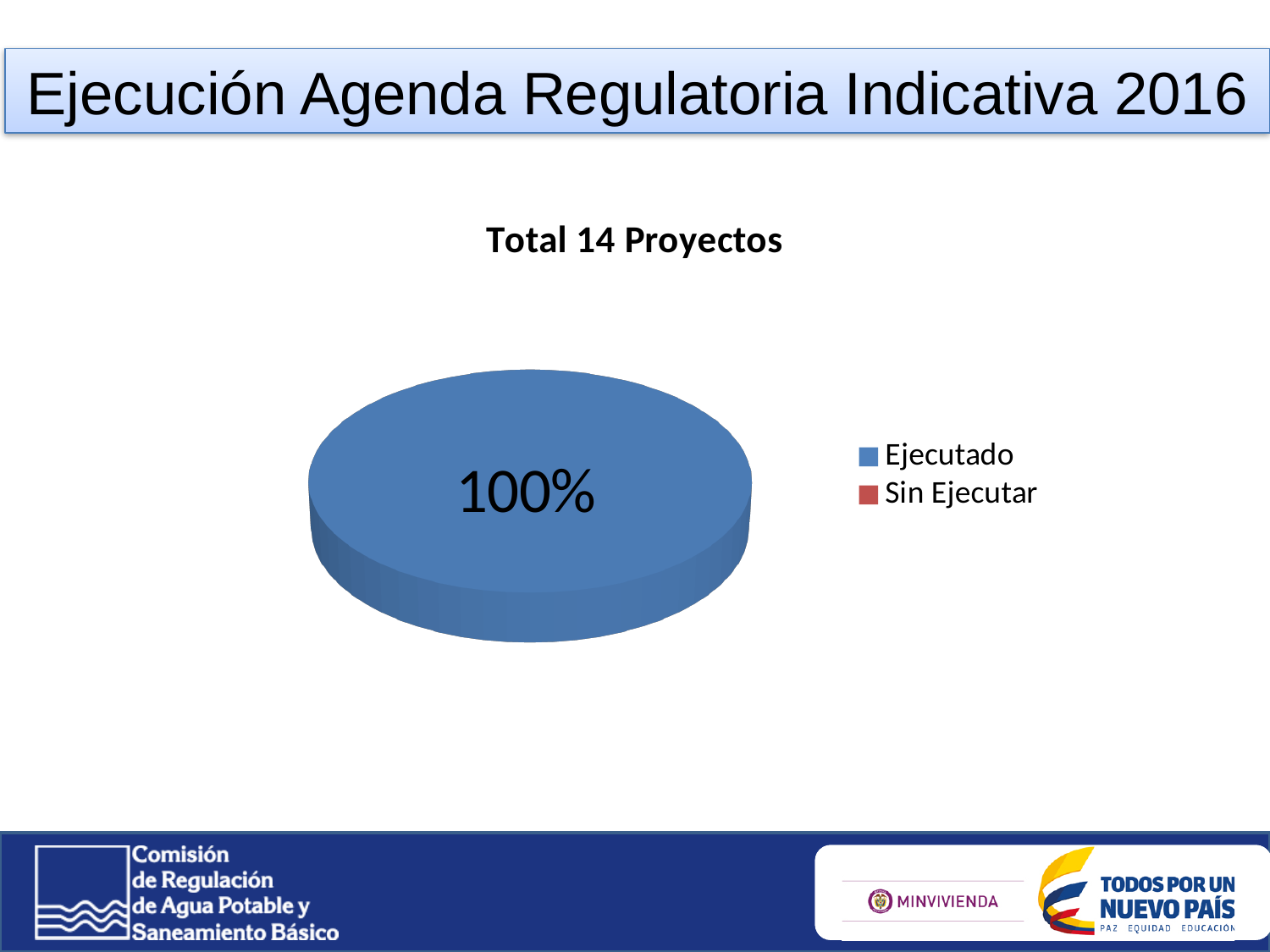
What colour represents Ejecutado in the chart? blue What kind of chart is shown on the slide? pie chart Which is larger, the share for Ejecutado or the share for Sin Ejecutar? Ejecutado Which category has the largest share of the pie? Ejecutado How many entries does the legend list? 2 Which category has the smallest share of the pie? Sin Ejecutar What share of the pie does Ejecutado represent? 100% How many projects does the chart title say are included in total? 14 What percentage value is printed on the pie chart? 100% What is the title of the chart? Total 14 Proyectos